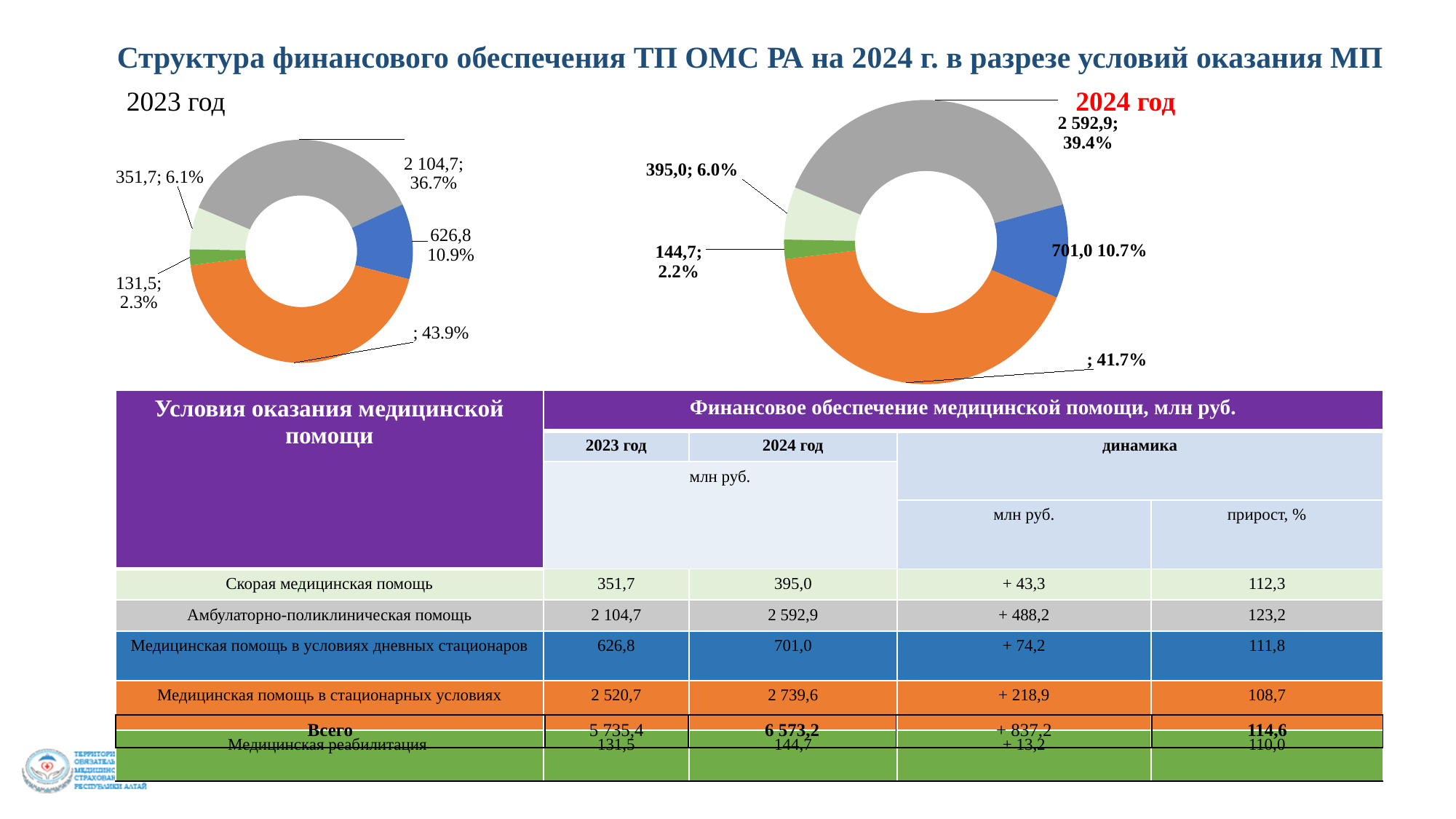
In the 2023 год chart, what is the smallest share shown? 2.3% In the 2023 год chart, what share is shown for the orange slice? 43.9% What is the title of the slide containing the two charts? Структура финансового обеспечения ТП ОМС РА на 2024 г. в разрезе условий оказания МП What kind of chart is used to show the 2023 and 2024 structures on the slide? pie chart (donut) How many slices does the 2023 год chart have? 5 In the 2024 год chart, what share is shown for the grey slice (Амбулаторно-поликлиническая помощь)? 39.4% Is the share of the grey slice larger in the 2023 год chart or in the 2024 год chart? 2024 год In the 2024 год chart, what value is labelled on the dark green slice (Медицинская реабилитация)? 144,7 In the 2024 год chart, by how many percentage points does the orange slice (41.7%) exceed the grey slice (39.4%)? 2.3 In the 2023 год chart, what value is labelled on the light green slice (Скорая медицинская помощь)? 351,7 What is the difference between the blue slice value in the 2024 год chart (701,0) and in the 2023 год chart (626,8)? 74,2 In the 2024 год chart, which slice has the largest share? the orange slice, 41.7%